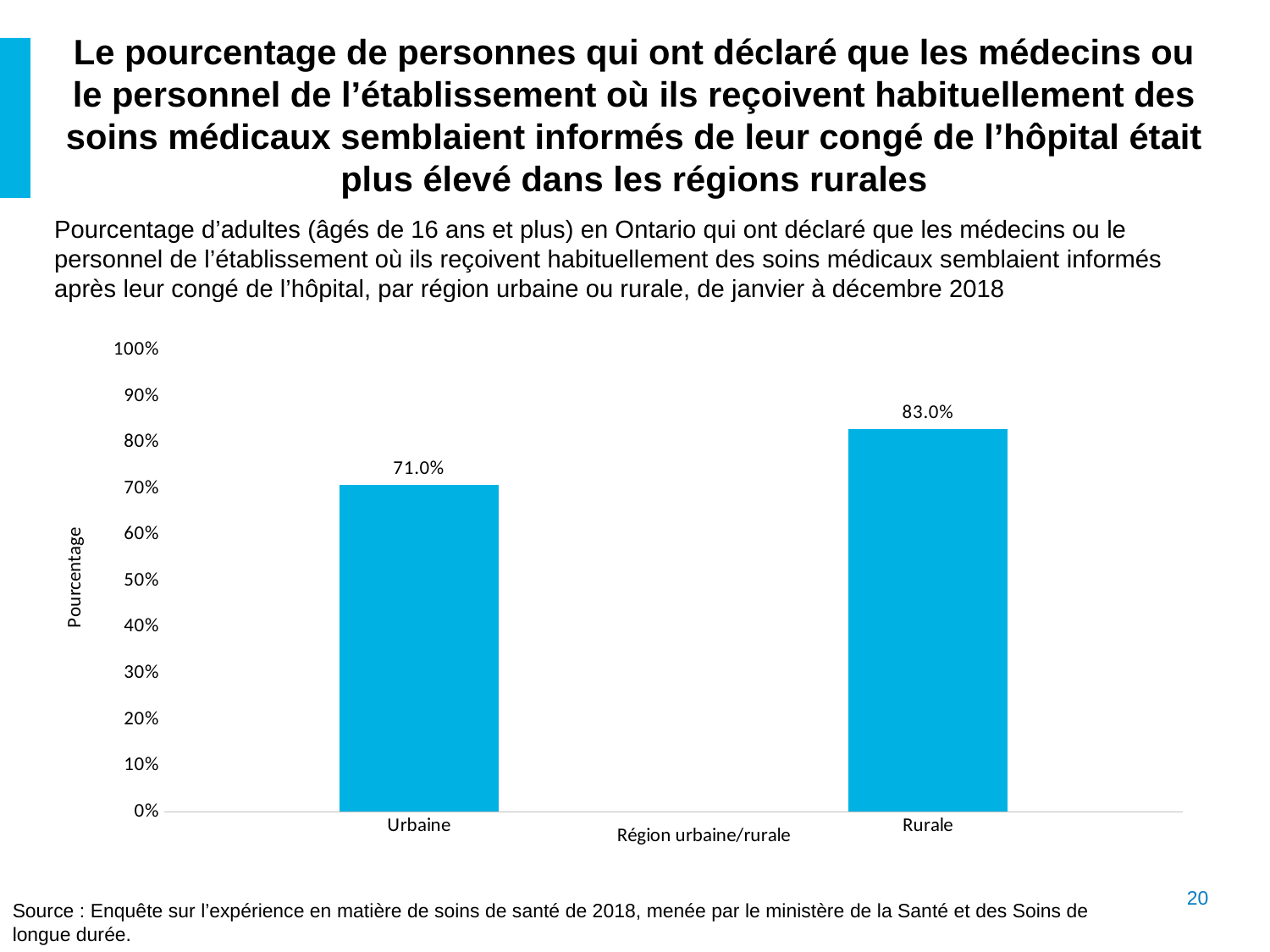
What is the value for Rurale? 83.0% Which category has the highest value? Rurale Is the value for Urbaine greater or less than 80%? less Which category has the lowest value? Urbaine What is the value for Urbaine? 71.0% What is the label of the y axis? Pourcentage What is the difference between the values for Rurale and Urbaine? 12.0% Is the value for Rurale greater or less than 80%? greater What kind of chart is shown on the slide? bar chart Which is larger, the value for Urbaine or the value for Rurale? Rurale How many categories are shown on the x axis? 2 What is the label of the x axis? Région urbaine/rurale